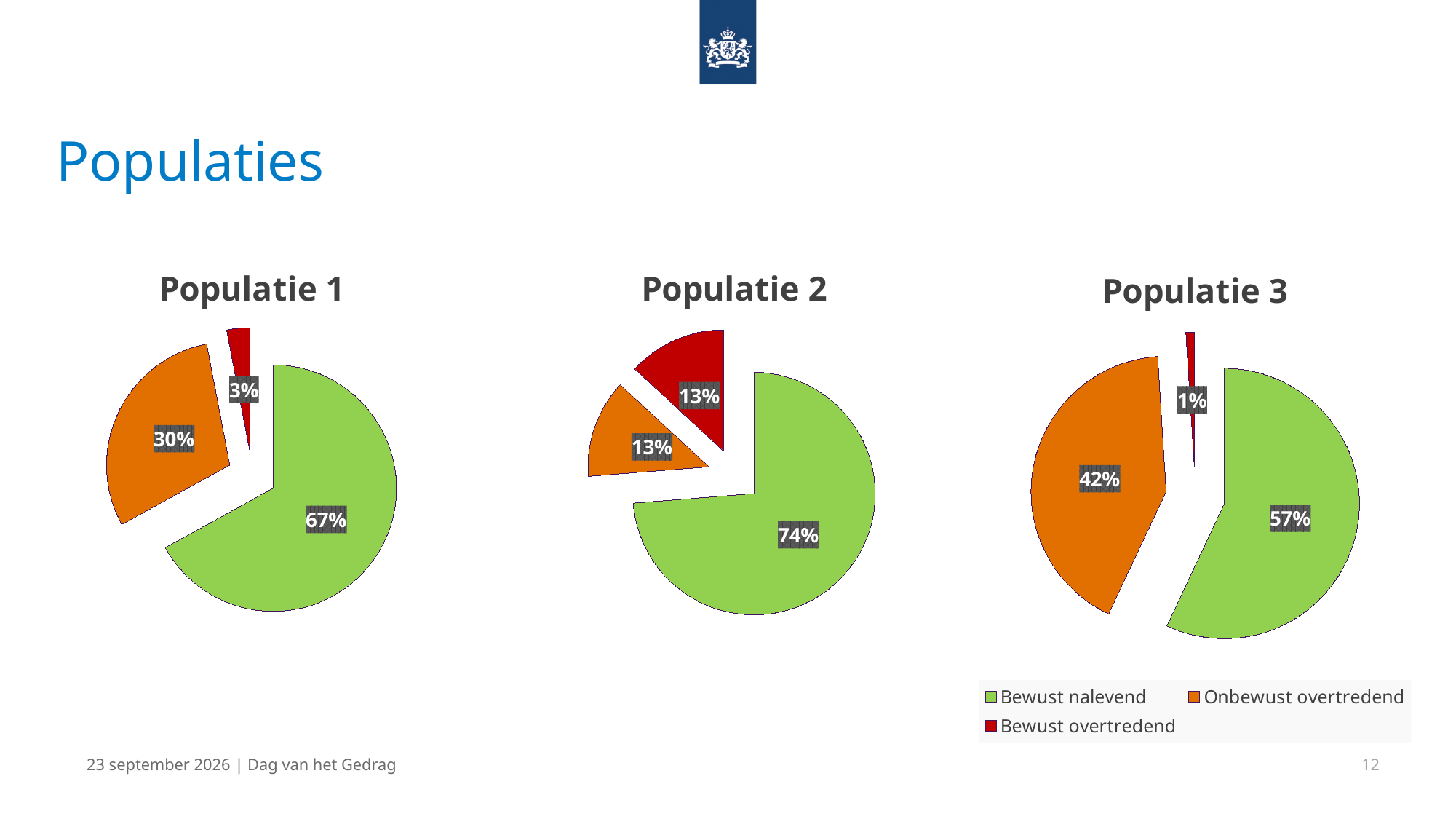
What type of chart is used for Populatie 1? Pie chart In the Populatie 3 chart, what share is Bewust overtredend? 1% How many slices does the Populatie 2 chart have? 3 In the Populatie 3 chart, what is the difference between the Bewust nalevend and Onbewust overtredend shares? 15% In the Populatie 1 chart, what share is Bewust nalevend? 67% In the Populatie 2 chart, what share is Bewust overtredend? 13% In the Populatie 1 chart, which category has the smallest slice? Bewust overtredend Which is larger: the Bewust nalevend share in Populatie 2 or in Populatie 1? Populatie 2 In the Populatie 2 chart, which category has the largest slice? Bewust nalevend How many entries does the legend list? 3 In the Populatie 1 chart, what share is Onbewust overtredend? 30% In the Populatie 3 chart, what share is Onbewust overtredend? 42%